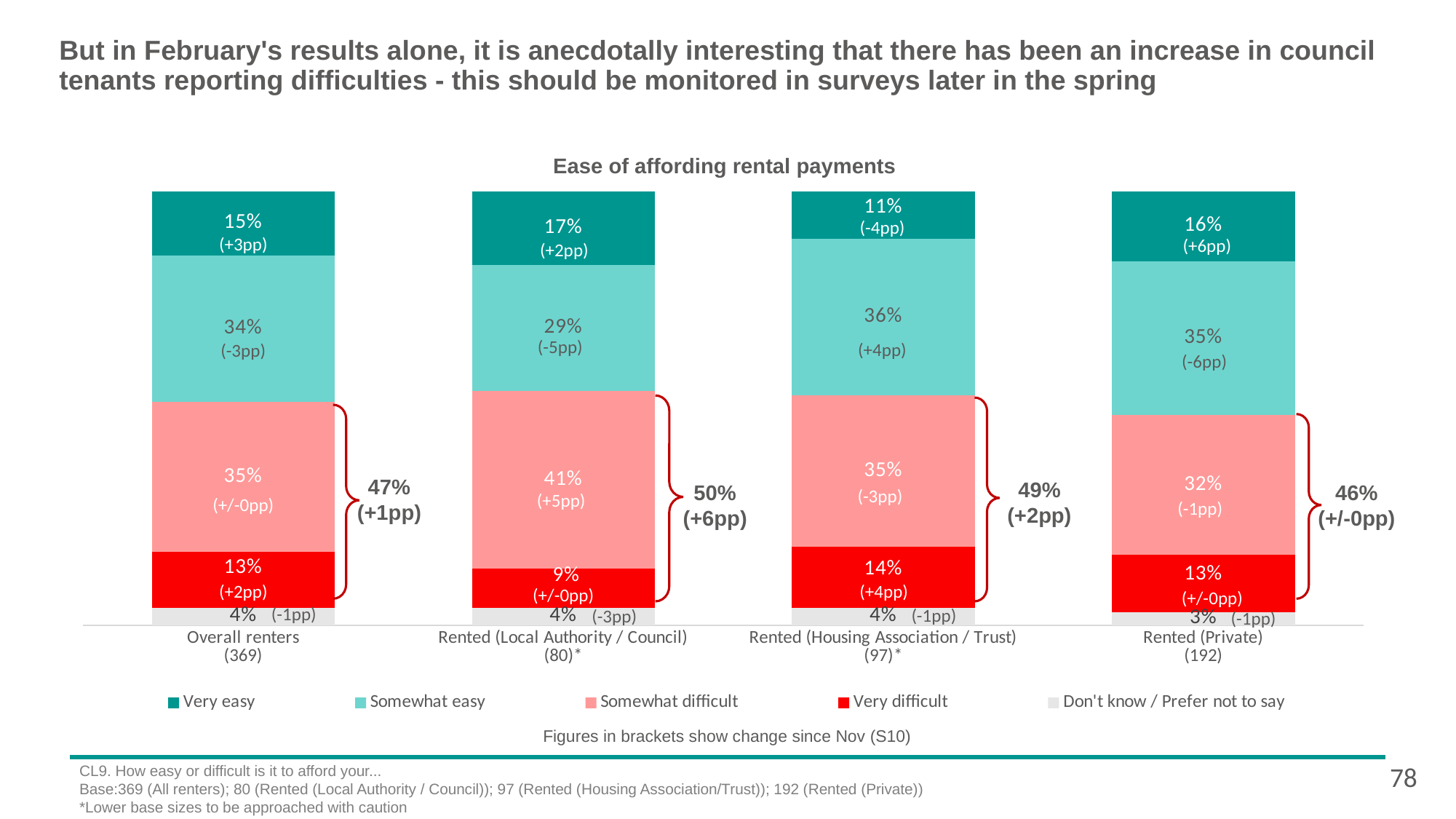
What percentage of Rented (Private) respondents said it is very easy? 16% Which is larger: the Very difficult percentage for Overall renters or for Rented (Local Authority / Council)? Overall renters What is the difference between the Somewhat easy percentages for Rented (Housing Association / Trust) and Rented (Local Authority / Council)? 7 percentage points Which category has the lowest percentage for Very easy? Rented (Housing Association / Trust) How many series does the legend list? 5 What kind of chart is shown on the slide? Stacked bar chart What percentage of Rented (Housing Association / Trust) respondents said it is very difficult? 14% Which category has the highest percentage for Somewhat difficult? Rented (Local Authority / Council) How many categories are shown on the x axis? 4 What is the combined percentage of Somewhat difficult and Very difficult for Rented (Private), as shown by the bracket? 46% What percentage of Rented (Local Authority / Council) respondents said it is somewhat difficult to afford rental payments? 41% What is the title of the chart? Ease of affording rental payments